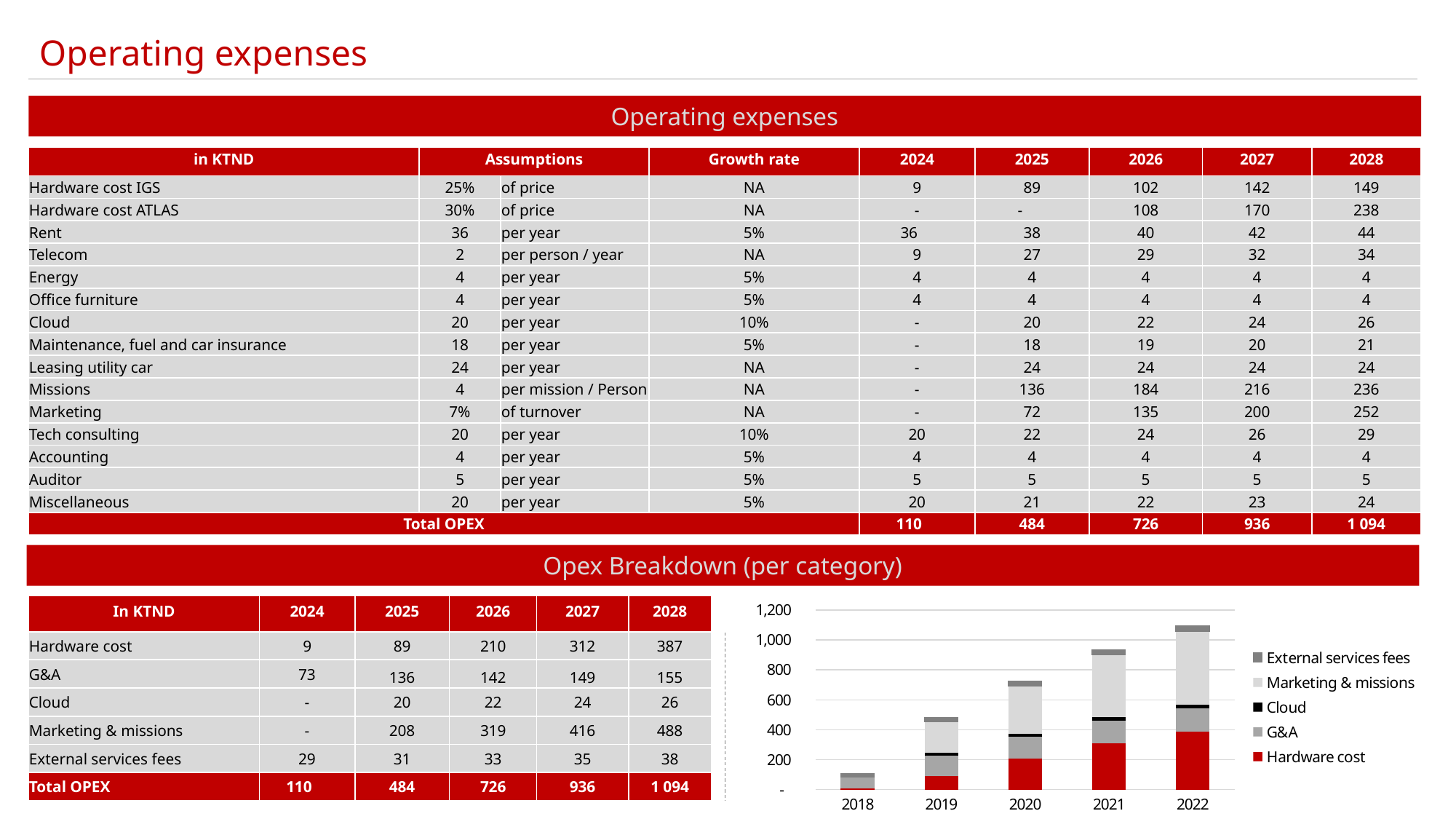
What kind of chart is shown on the slide? bar chart Is the total bar height for 2021 greater or less than 800? greater Which year has the taller stacked bar, 2019 or 2021? 2021 Is the total bar height for 2020 greater or less than 800? less Is the total bar height for 2018 greater or less than 200? less Which year has the tallest stacked bar in the chart? 2022 Which series is shown in red in the chart? Hardware cost Do the total bar heights rise or fall from 2018 to 2022 in the chart? rise Which year has the shortest stacked bar in the chart? 2018 How many years are shown along the x axis of the chart? 5 How many series does the chart's legend list? 5